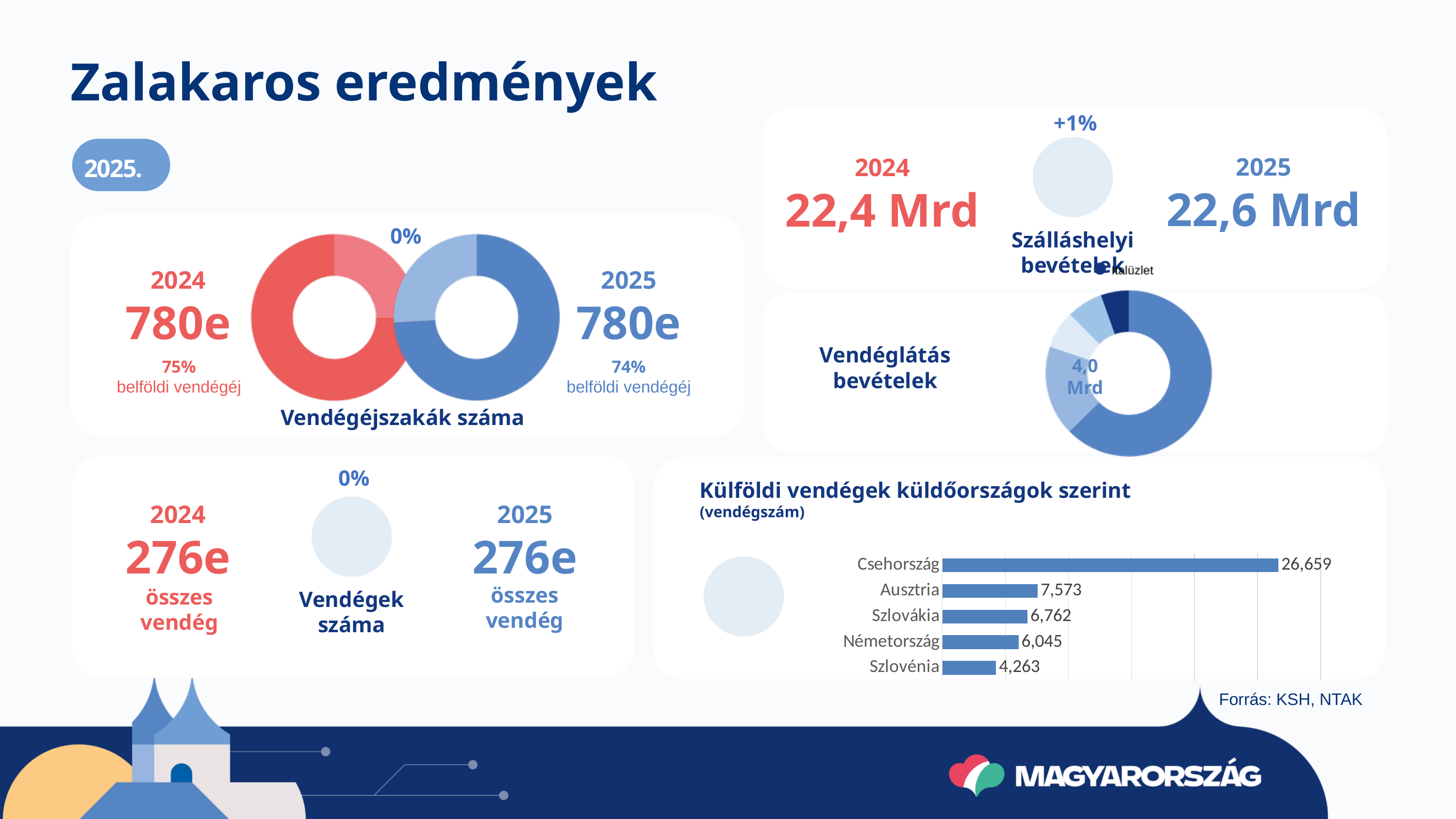
In the 'Külföldi vendégek küldőországok szerint' bar chart, which country has the lowest value? Szlovénia In the 'Külföldi vendégek küldőországok szerint' bar chart, which is larger, the value for Ausztria or the value for Szlovákia? Ausztria In the 'Vendégéjszakák száma' donut charts, what share of guest nights was domestic (belföldi vendégéj) in 2025? 74% How many countries are shown in the 'Külföldi vendégek küldőországok szerint' bar chart? 5 In the 'Külföldi vendégek küldőországok szerint' bar chart, what is the value for Szlovénia? 4,263 What value is shown in the 'Vendéglátás bevételek' donut chart? 4,0 Mrd In the 'Külföldi vendégek küldőországok szerint' bar chart, what is the value for Németország? 6,045 In the 'Külföldi vendégek küldőországok szerint' bar chart, what is the difference between the values for Csehország and Ausztria? 19,086 In the 'Külföldi vendégek küldőországok szerint' bar chart, what is the difference between the values for Németország and Szlovénia? 1,782 In the 'Külföldi vendégek küldőországok szerint' bar chart, which country has the highest value? Csehország What kind of chart is 'Külföldi vendégek küldőországok szerint'? bar chart In the 'Külföldi vendégek küldőországok szerint' bar chart, what is the value for Csehország? 26,659